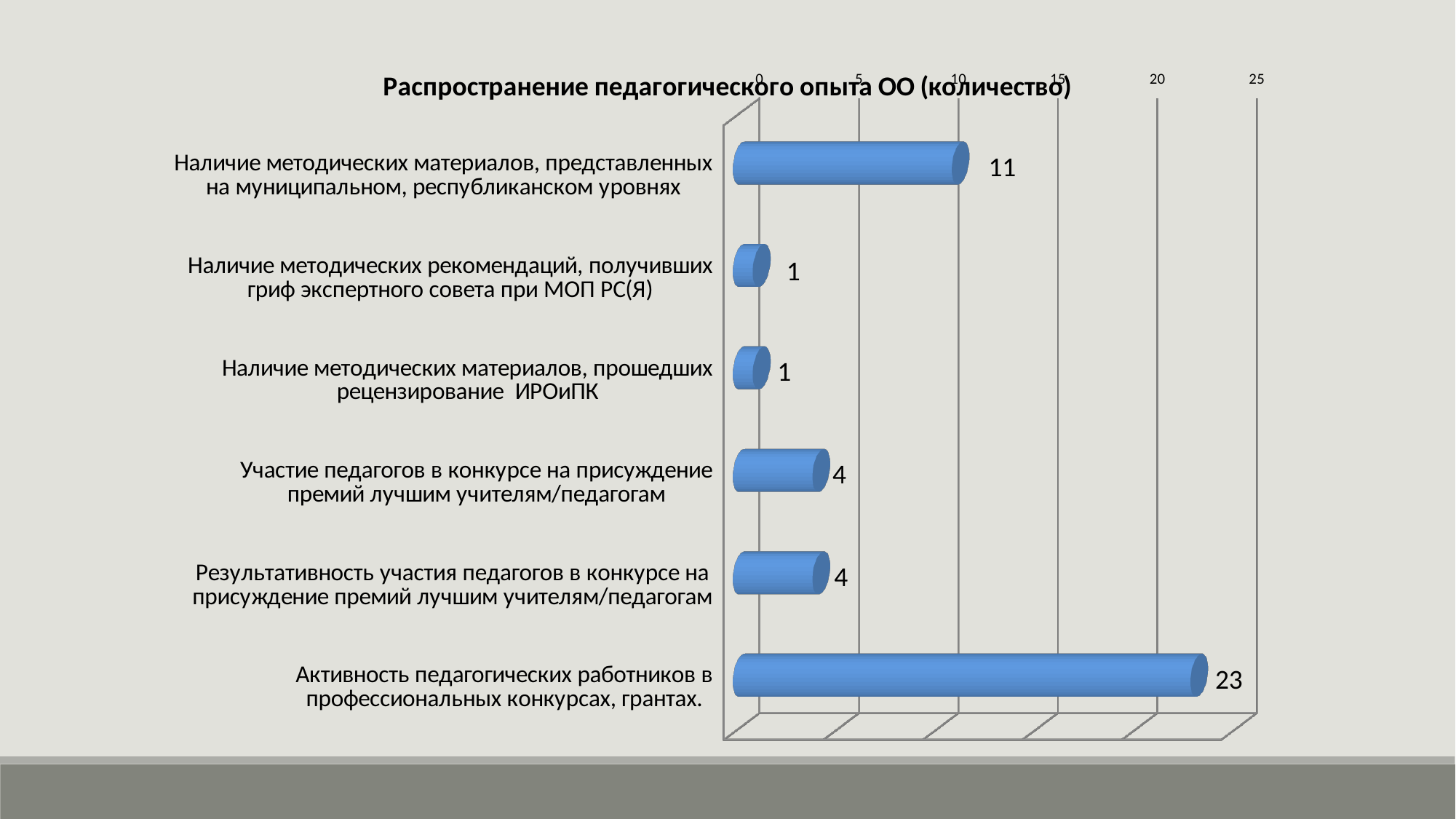
What is the difference between the value for "Активность педагогических работников в профессиональных конкурсах, грантах." and the value for "Наличие методических материалов, представленных на муниципальном, республиканском уровнях"? 12 What is the value for "Наличие методических рекомендаций, получивших гриф экспертного совета при МОП РС(Я)"? 1 What kind of chart is shown on the slide? bar chart How many categories are shown in the chart? 6 What is the title of the chart? Распространение педагогического опыта ОО (количество) What is the value for "Наличие методических материалов, представленных на муниципальном, республиканском уровнях"? 11 What is the value for "Участие педагогов в конкурсе на присуждение премий лучшим учителям/педагогам"? 4 Which is larger: the value for "Наличие методических материалов, представленных на муниципальном, республиканском уровнях" or the value for "Участие педагогов в конкурсе на присуждение премий лучшим учителям/педагогам"? Наличие методических материалов, представленных на муниципальном, республиканском уровнях Which category has the highest value? Активность педагогических работников в профессиональных конкурсах, грантах. Is the value for "Активность педагогических работников в профессиональных конкурсах, грантах." greater or less than 20? greater What is the value for "Активность педагогических работников в профессиональных конкурсах, грантах."? 23 What is the difference between the value for "Участие педагогов в конкурсе на присуждение премий лучшим учителям/педагогам" and the value for "Наличие методических материалов, прошедших рецензирование ИРОиПК"? 3